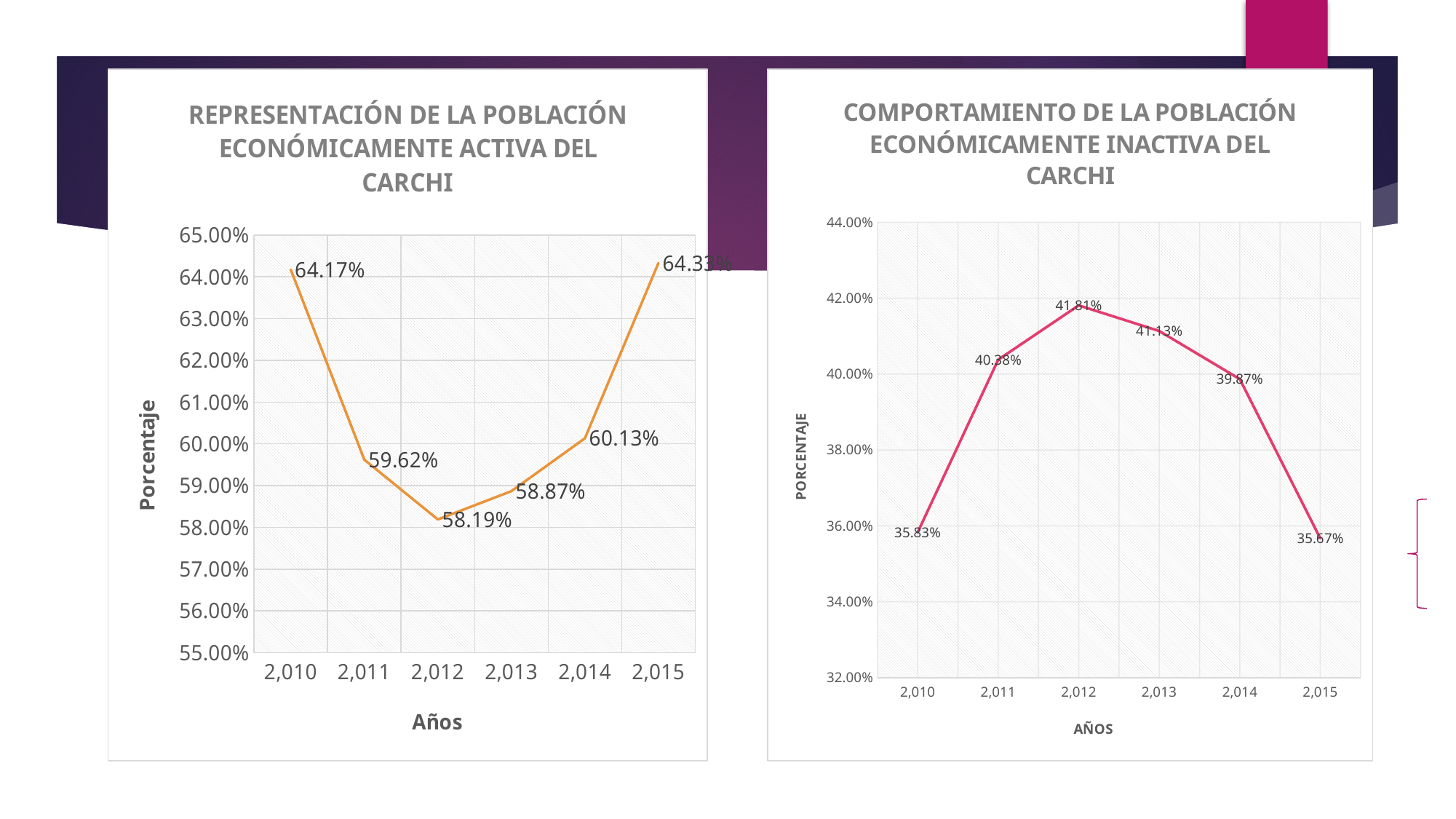
In the left chart (Representación de la Población Económicamente Activa del Carchi), what is the value for 2,010? 64.17% In the right chart (Comportamiento de la Población Económicamente Inactiva del Carchi), which year has the lowest value? 2,015 In the right chart (Comportamiento de la Población Económicamente Inactiva del Carchi), what is the difference between the values for 2,012 and 2,010? 5.98% In the left chart (Representación de la Población Económicamente Activa del Carchi), what is the difference between the values for 2,015 and 2,010? 0.16% What kind of chart is the right chart (Comportamiento de la Población Económicamente Inactiva del Carchi)? Line chart How many years are plotted in the left chart (Representación de la Población Económicamente Activa del Carchi)? 6 In the left chart (Representación de la Población Económicamente Activa del Carchi), which year has the highest value? 2,015 In the right chart (Comportamiento de la Población Económicamente Inactiva del Carchi), is the value for 2,011 larger or smaller than the value for 2,013? smaller In the right chart (Comportamiento de la Población Económicamente Inactiva del Carchi), what is the value for 2,014? 39.87% In the right chart (Comportamiento de la Población Económicamente Inactiva del Carchi), what is the value for 2,012? 41.81% In the left chart (Representación de la Población Económicamente Activa del Carchi), what is the value for 2,013? 58.87% In the left chart (Representación de la Población Económicamente Activa del Carchi), which year has the lowest value? 2,012